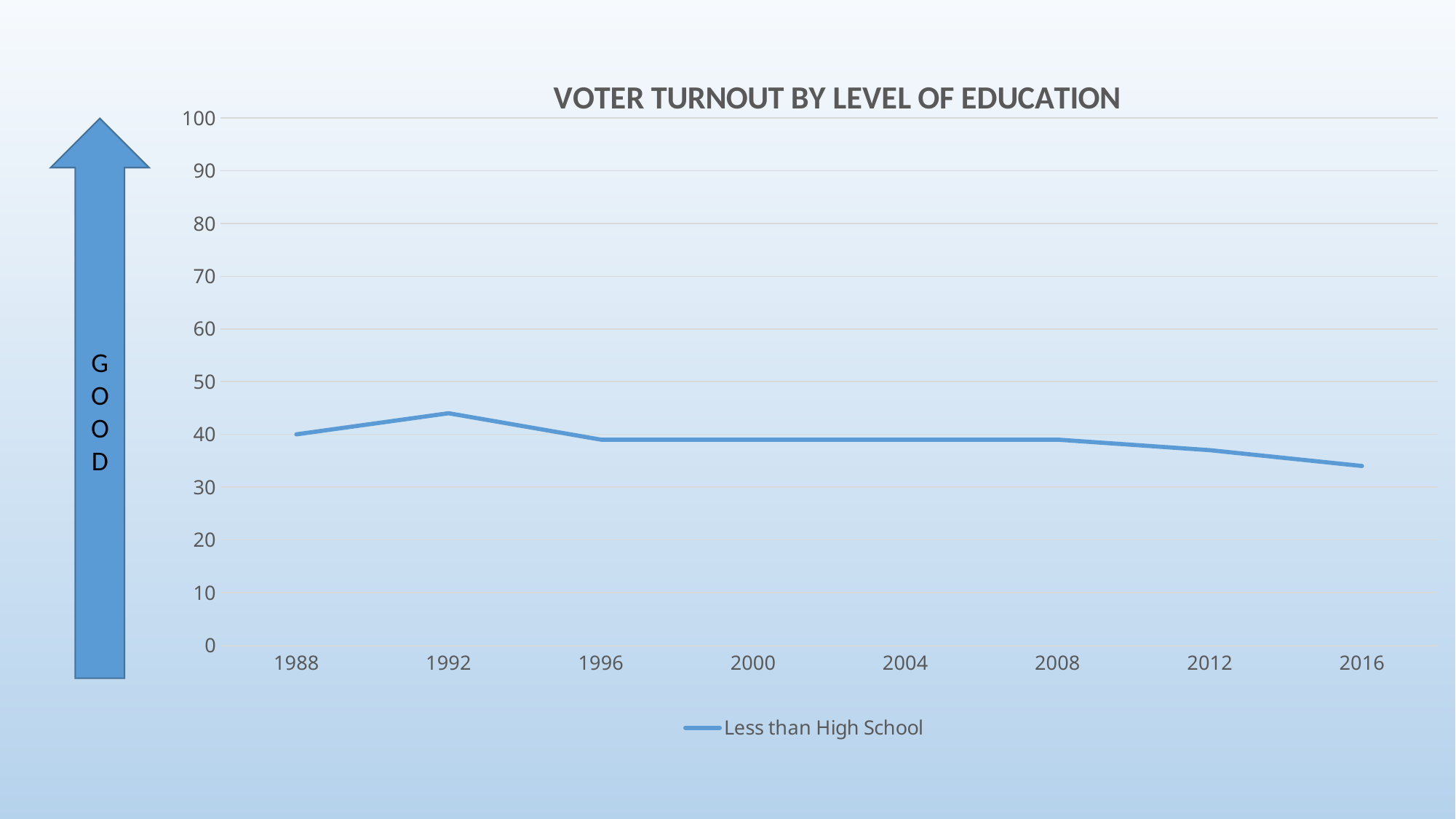
Does the Less than High School turnout rise or fall from 1992 to 2016? fall In which year is the Less than High School turnout lowest? 2016 How many years are plotted along the x axis? 8 Is the value for 2016 greater or less than 40? less Is the value for 1988 greater or less than 50? less What series name is shown in the legend? Less than High School Which year has the larger turnout value, 1992 or 2016? 1992 How many series does the legend list? 1 What is the title of the chart? VOTER TURNOUT BY LEVEL OF EDUCATION In which year is the Less than High School turnout highest? 1992 What kind of chart is shown on the slide? line chart Is the value for 1992 greater or less than 40? greater